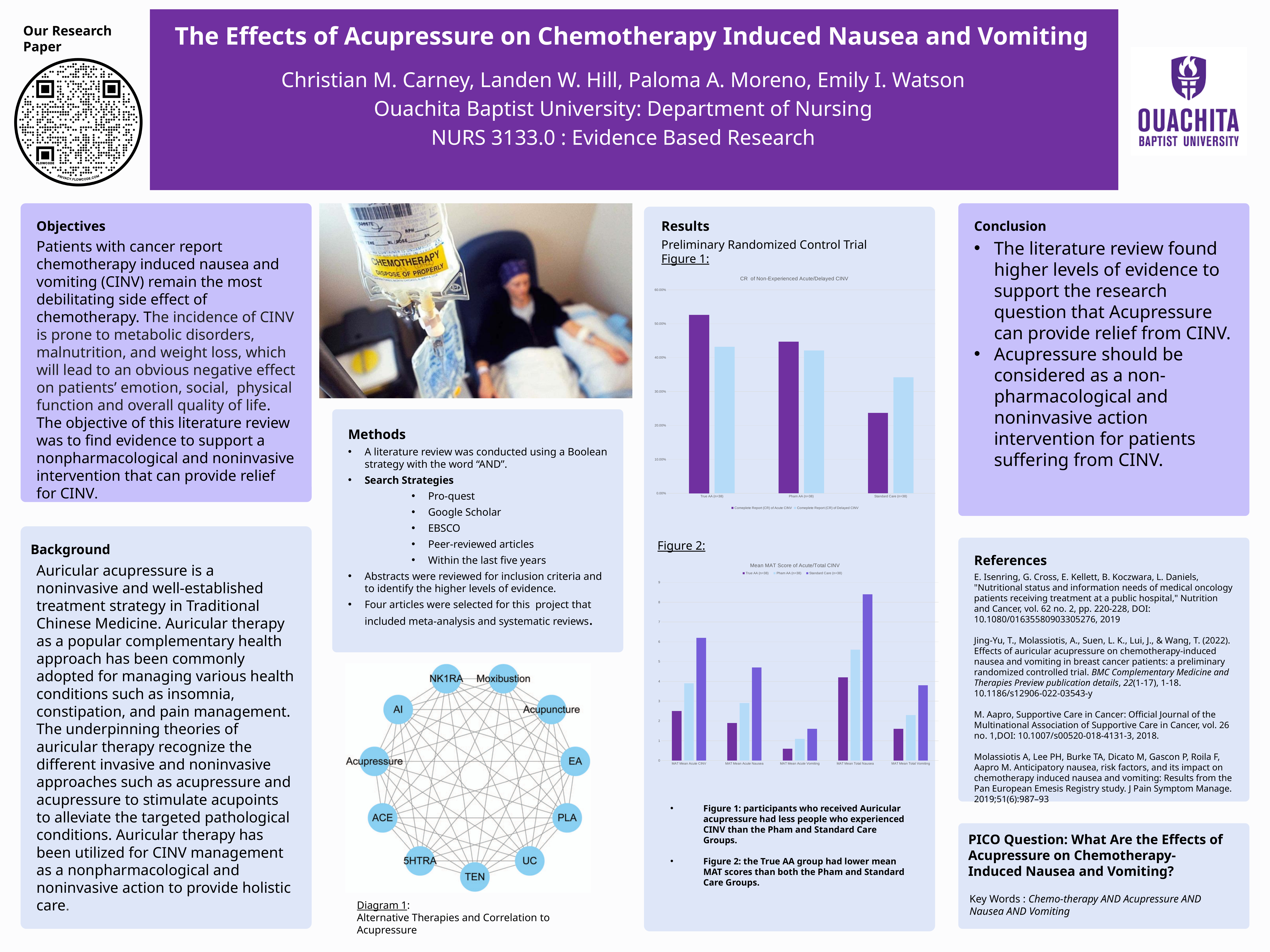
How many categories are shown on the x axis of Figure 2? 5 In Figure 1, which group has the highest Complete Report of Acute CINV? True AA (n=38) How many groups are shown on the x axis of Figure 1? 3 In Figure 2, for MAT Mean Acute CINV, which is larger: True AA (n=38) or Standard Care (n=38)? Standard Care (n=38) In Figure 1, is the Complete Report of Acute CINV value for True AA (n=38) greater or less than 50.00%? greater In Figure 1, is the Complete Report of Acute CINV value for Standard Care (n=38) greater or less than 30.00%? less What kind of chart is Figure 1 (CR of Non-Experienced Acute/Delayed CINV)? bar chart How many series does the legend of Figure 1 list? 2 In Figure 1, which group has the lowest Complete Report of Delayed CINV? Standard Care (n=38) What kind of chart is Figure 2 (Mean MAT Score of Acute/Total CINV)? bar chart In Figure 2, which category has the highest Standard Care (n=38) value? MAT Mean Total Nausea How many series does the legend of Figure 2 list? 3